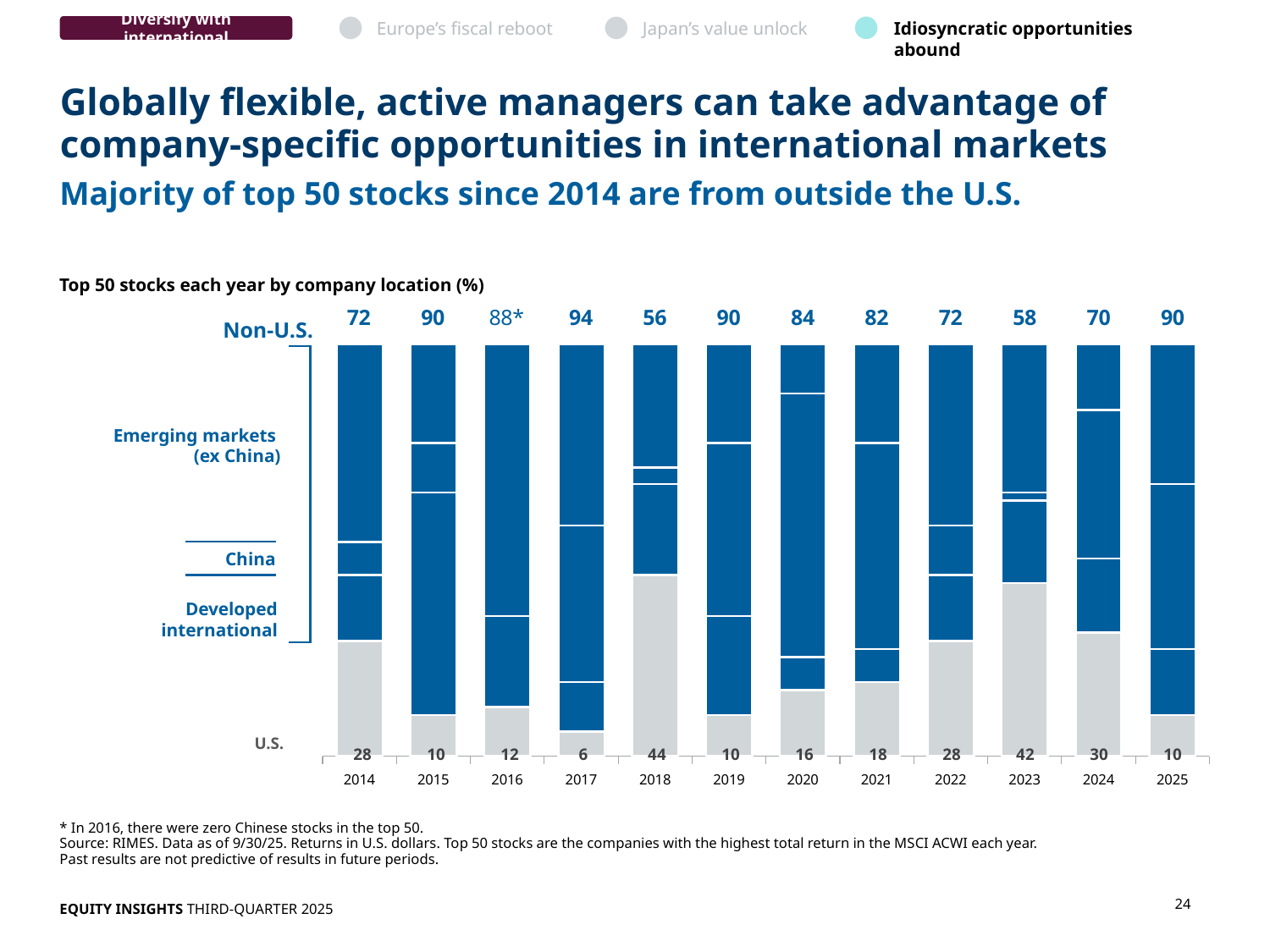
From 2021 to 2023, does the Non-U.S. percentage rise or fall? Fall Which year has the larger U.S. percentage, 2020 or 2021? 2021 Which year has the lowest U.S. percentage of top 50 stocks? 2017 What is the U.S. percentage shown for 2025? 10 According to the footnote, what does the asterisk on the 2016 value indicate? There were zero Chinese stocks in the top 50 How many years are shown on the x axis of the chart? 12 What kind of chart is used to show top 50 stocks by company location? Stacked bar chart What is the Non-U.S. percentage shown for 2017? 94 Which year has the highest U.S. percentage of top 50 stocks? 2018 How much higher is the U.S. percentage in 2023 than in 2014? 14 What percentage of the top 50 stocks were U.S. companies in 2018? 44 Which year has the lowest Non-U.S. percentage? 2018